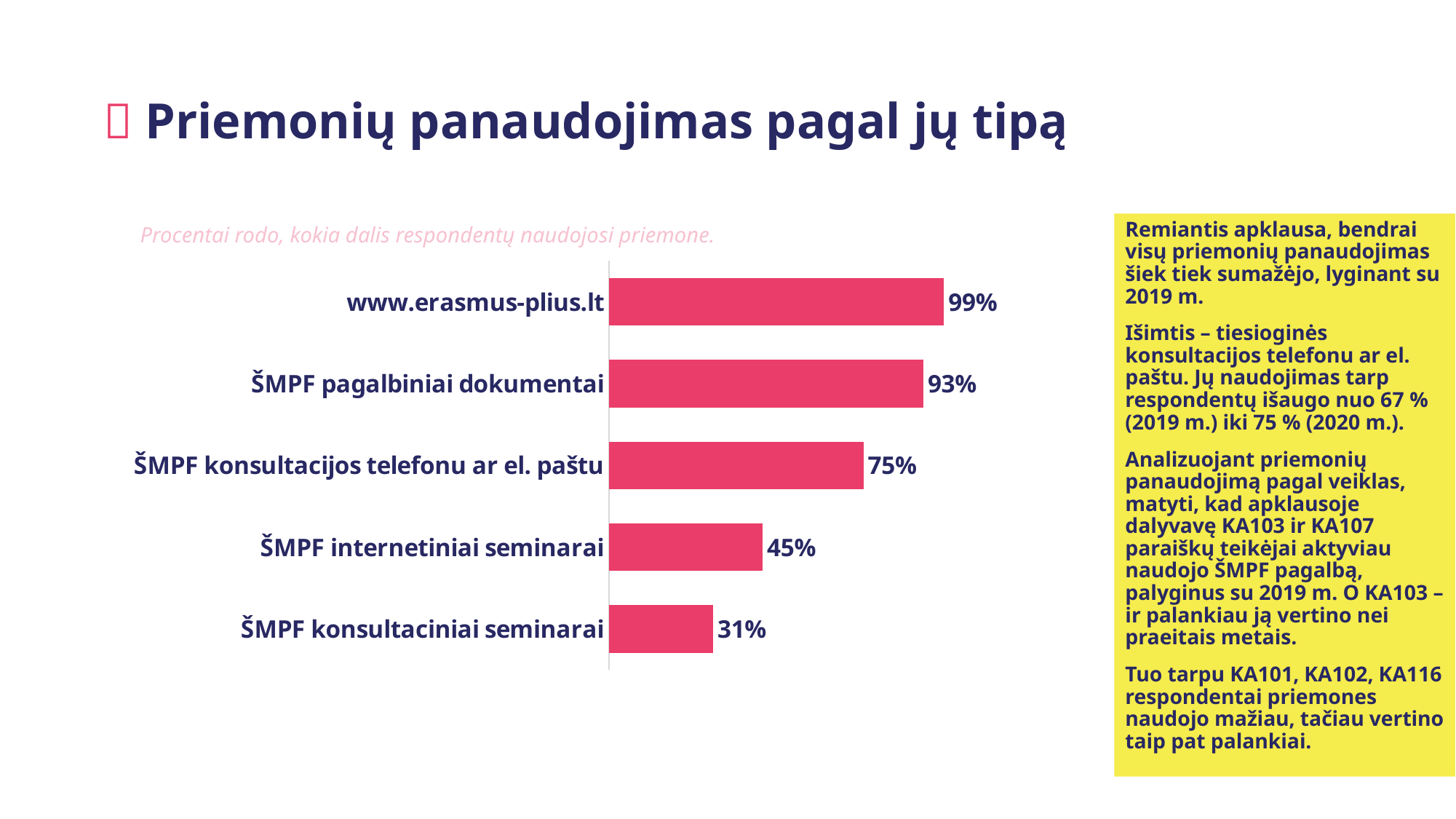
What is the value shown for ŠMPF konsultacijos telefonu ar el. paštu? 75% What kind of chart is shown on the slide? Bar chart Which category has the lowest value in the chart? ŠMPF konsultaciniai seminarai Which category has the highest value in the chart? www.erasmus-plius.lt What is the value shown for ŠMPF konsultaciniai seminarai? 31% What percentage of respondents used www.erasmus-plius.lt? 99% What is the difference between the values for www.erasmus-plius.lt and ŠMPF pagalbiniai dokumentai? 6% Which has a larger value: ŠMPF konsultacijos telefonu ar el. paštu or ŠMPF internetiniai seminarai? ŠMPF konsultacijos telefonu ar el. paštu How many categories are shown in the chart? 5 What is the value shown for ŠMPF internetiniai seminarai? 45% What is the difference between the values for ŠMPF internetiniai seminarai and ŠMPF konsultaciniai seminarai? 14% What is the value shown for ŠMPF pagalbiniai dokumentai? 93%